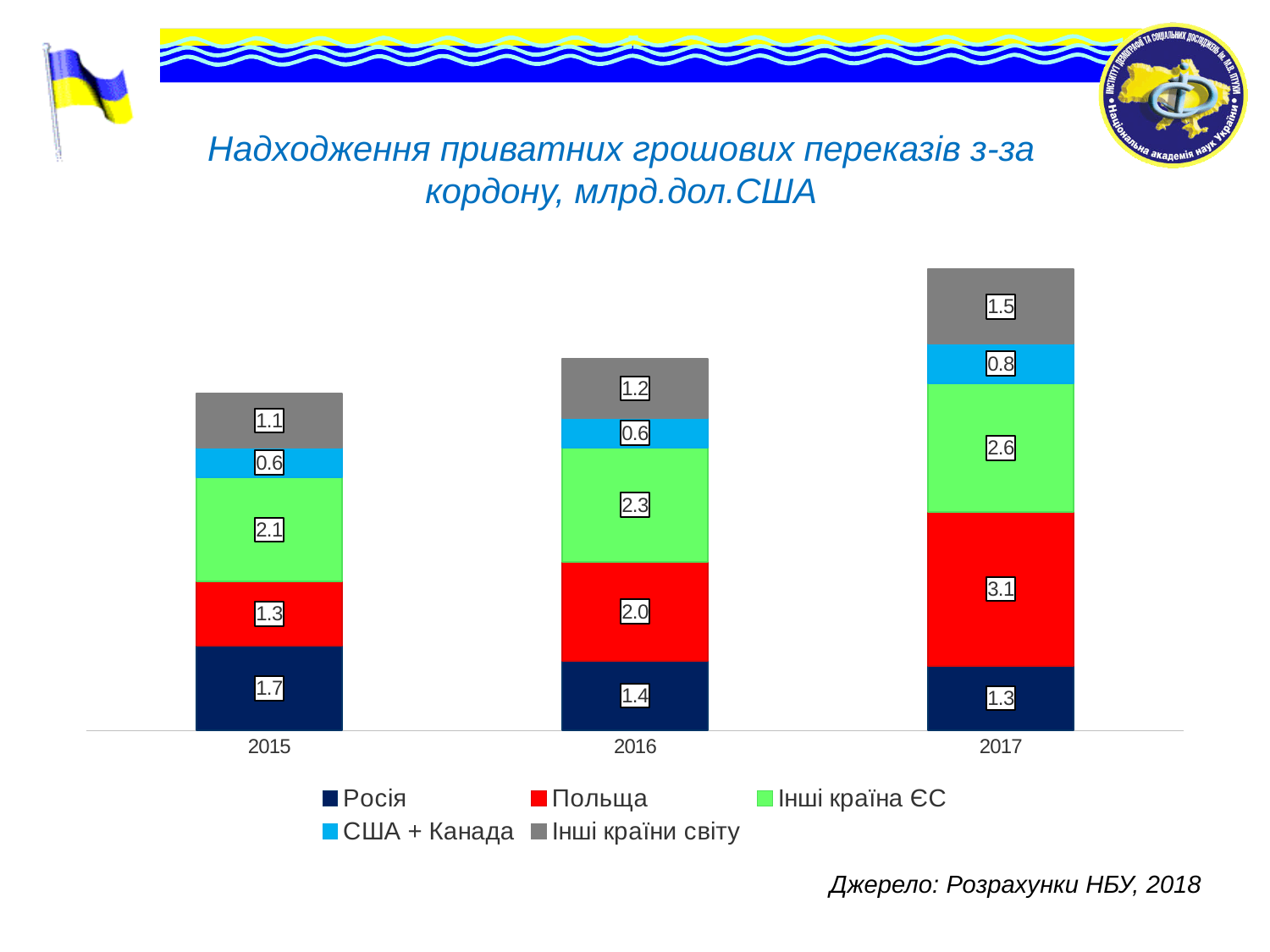
What is the value for США + Канада in 2017? 0.8 What is the total of the stacked bar for 2017? 9.3 What is the value for Інші країни світу in 2016? 1.2 Which is larger in 2016: the value for Польща or the value for Росія? Польща What is the difference between the Інші країна ЄС values in 2017 and 2015? 0.5 What is the value for Польща in 2017? 3.1 What is the value for Росія in 2015? 1.7 In which year is the value for Росія the lowest? 2017 What kind of chart is shown on the slide? Stacked bar chart In which year is the value for Польща the highest? 2017 How many series does the legend list? 5 What is the total of the stacked bar for 2015? 6.8